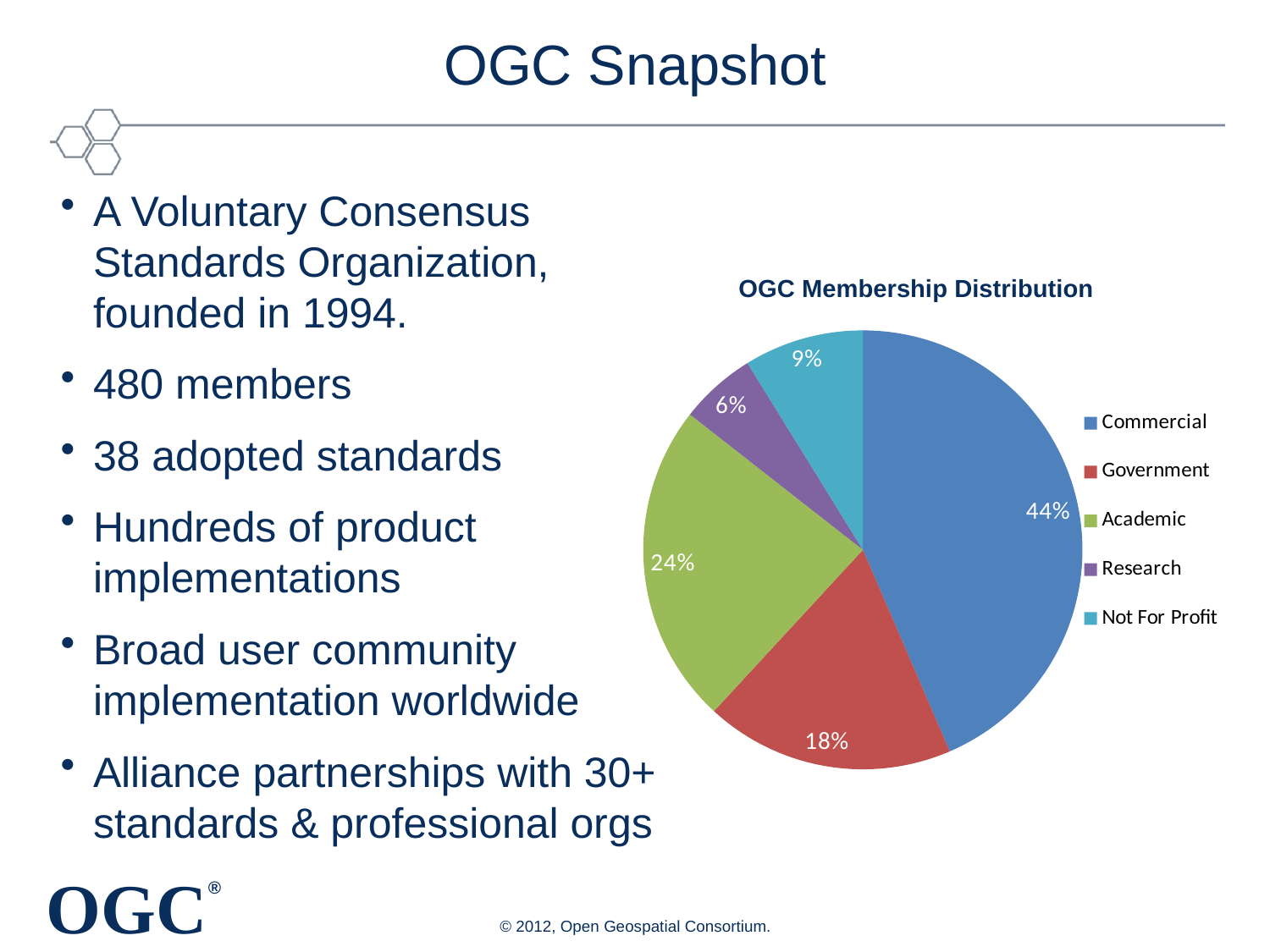
What share of OGC membership is Not For Profit? 9% What is the title of the chart? OGC Membership Distribution What share of OGC membership is Commercial? 44% What is the difference in percentage points between the Commercial and Academic shares? 20 What share of OGC membership is Government? 18% What share of OGC membership is Academic? 24% Which is larger, the Government share or the Not For Profit share? Government Which membership category has the smallest share? Research Which membership category has the largest share? Commercial What share of OGC membership is Research? 6% How many categories does the pie chart show? 5 What type of chart is shown on the slide? Pie chart